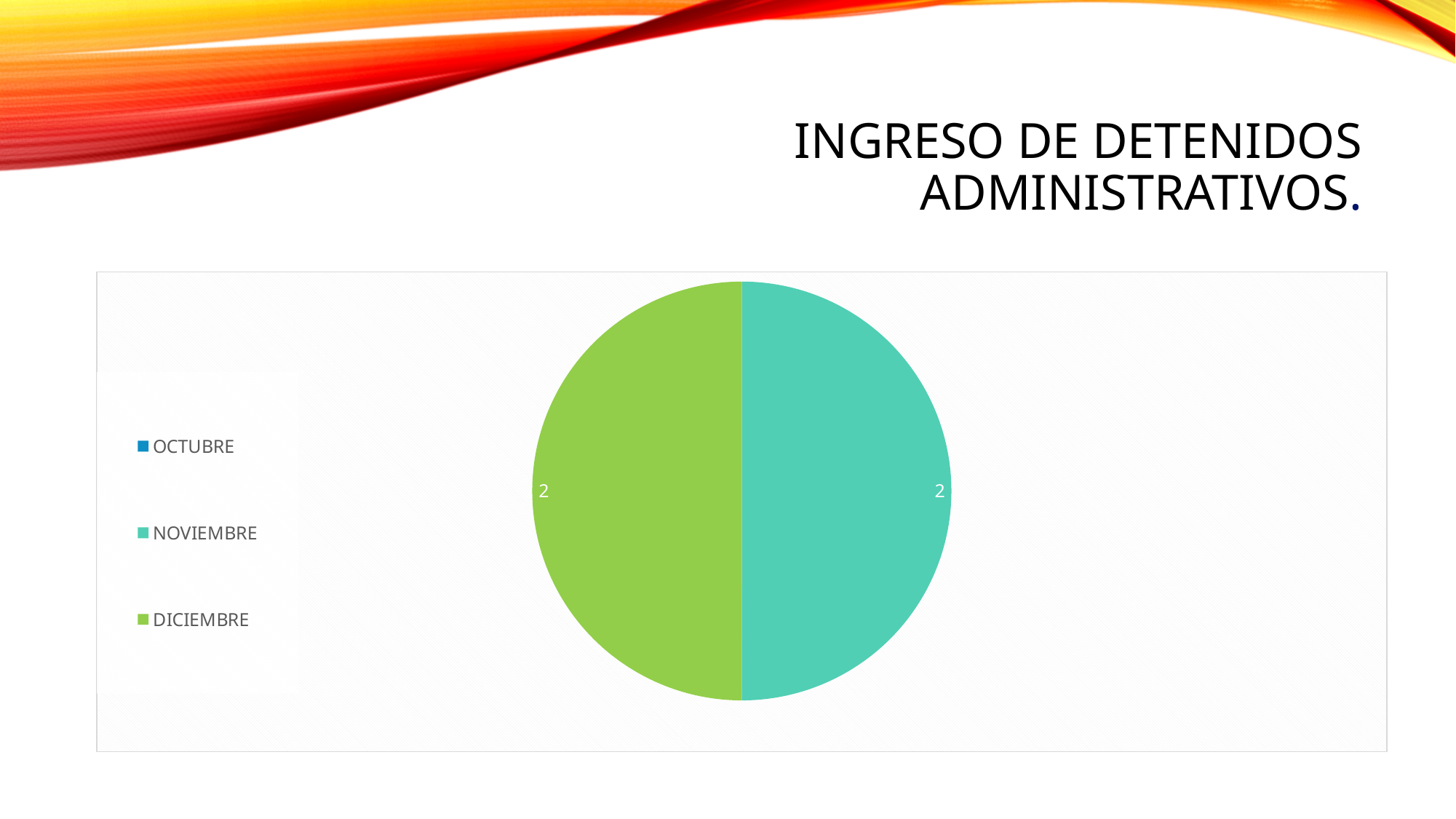
What share of the pie does the DICIEMBRE slice represent? 50% What kind of chart is shown on the slide? pie chart What is the difference between the values for NOVIEMBRE and DICIEMBRE? 0 What is the value shown for DICIEMBRE in the pie chart? 2 What share of the pie does the NOVIEMBRE slice represent? 50% What is the value shown for NOVIEMBRE in the pie chart? 2 Which legend entry has no visible slice in the pie chart? OCTUBRE What colour is the DICIEMBRE slice in the pie chart? green How many entries does the legend of the pie chart list? 3 How many slices are visible in the pie chart? 2